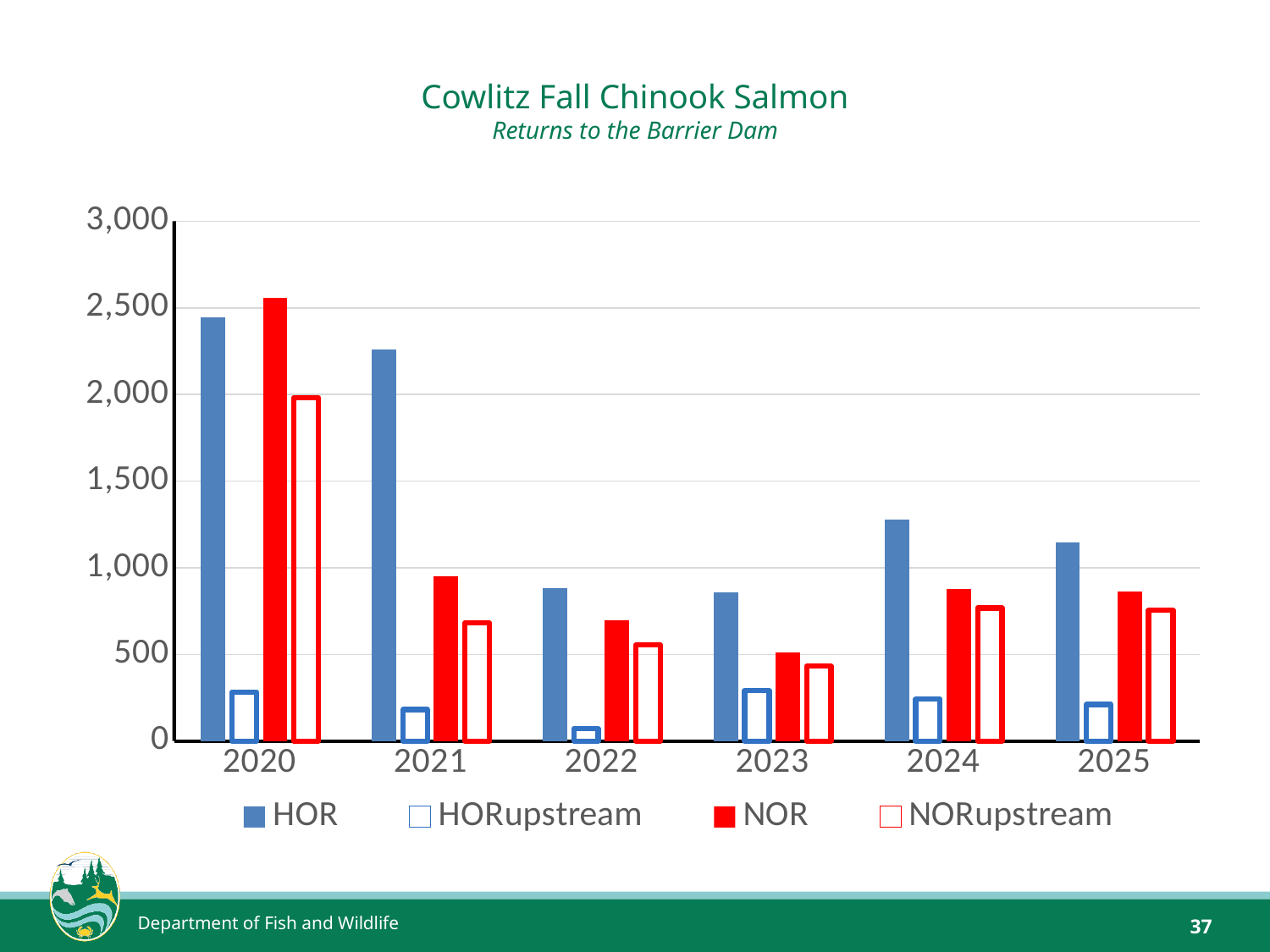
Is the NORupstream value for 2020 greater or less than 1,500? greater In which year is the HORupstream value lowest? 2022 Is the NOR value for 2023 greater or less than 1,000? less How many series does the legend list? 4 In which year is the HOR value highest? 2020 In which year is the NOR value highest? 2020 Does the HOR value rise or fall from 2020 to 2023? fall Which is larger in 2022, the HOR value or the NOR value? HOR How many years are shown on the x axis? 6 What is the title of the chart? Cowlitz Fall Chinook Salmon What kind of chart is shown on the slide? Bar chart Is the HOR value for 2021 greater or less than 2,000? greater